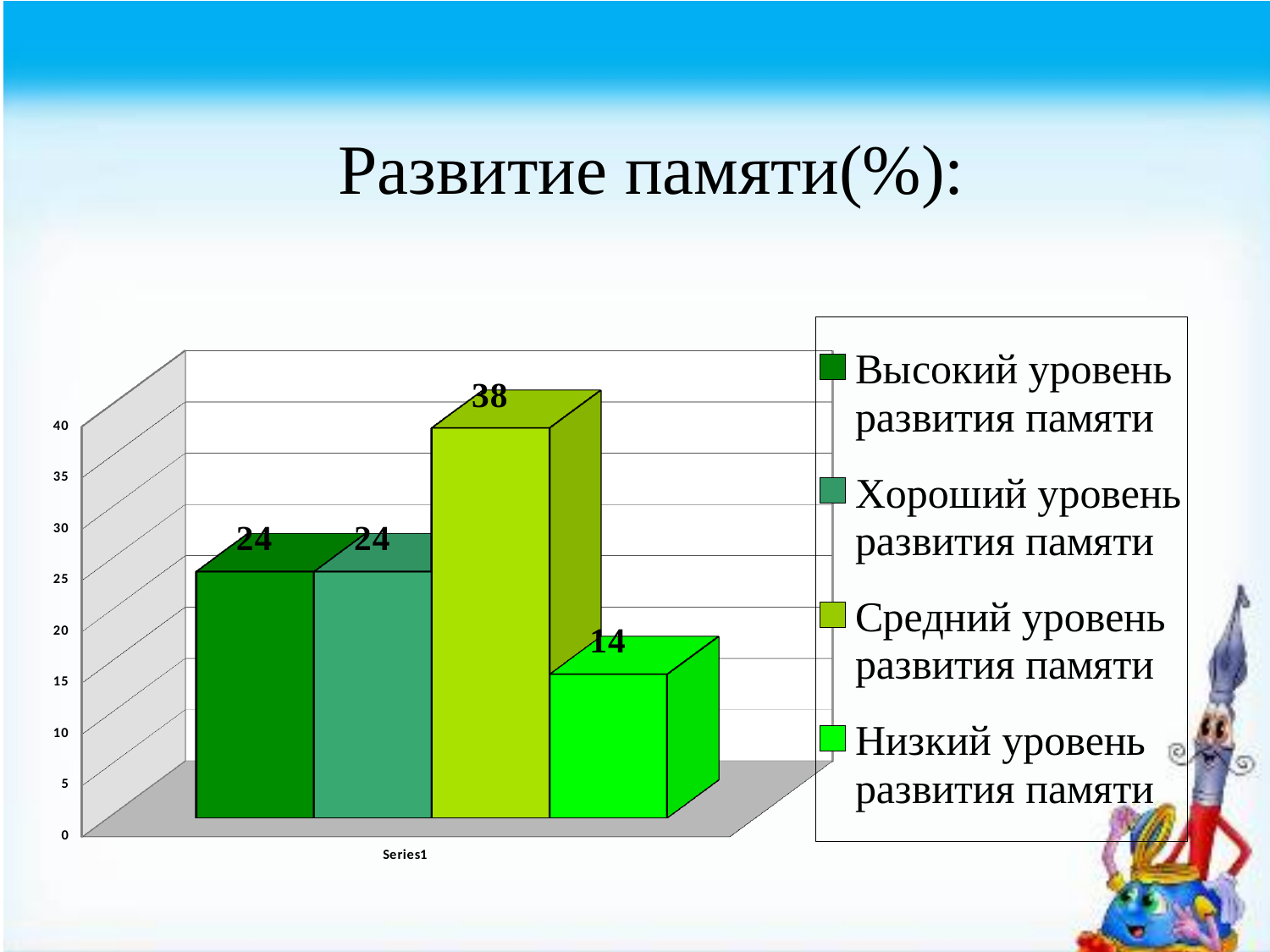
What is the value for Хороший уровень развития памяти? 24 What is the value for Низкий уровень развития памяти? 14 Which category has the highest value? Средний уровень развития памяти What is the value for Средний уровень развития памяти? 38 Which is larger, the value for Средний уровень развития памяти or the value for Высокий уровень развития памяти? Средний уровень развития памяти What is the value for Высокий уровень развития памяти? 24 What is the title of the slide? Развитие памяти(%): How many bars are plotted in the chart? 4 What is the difference between the values for Средний уровень развития памяти and Низкий уровень развития памяти? 24 Is the value for Низкий уровень развития памяти greater or less than 20? less Which category has the lowest value? Низкий уровень развития памяти What kind of chart is shown on the slide? bar chart